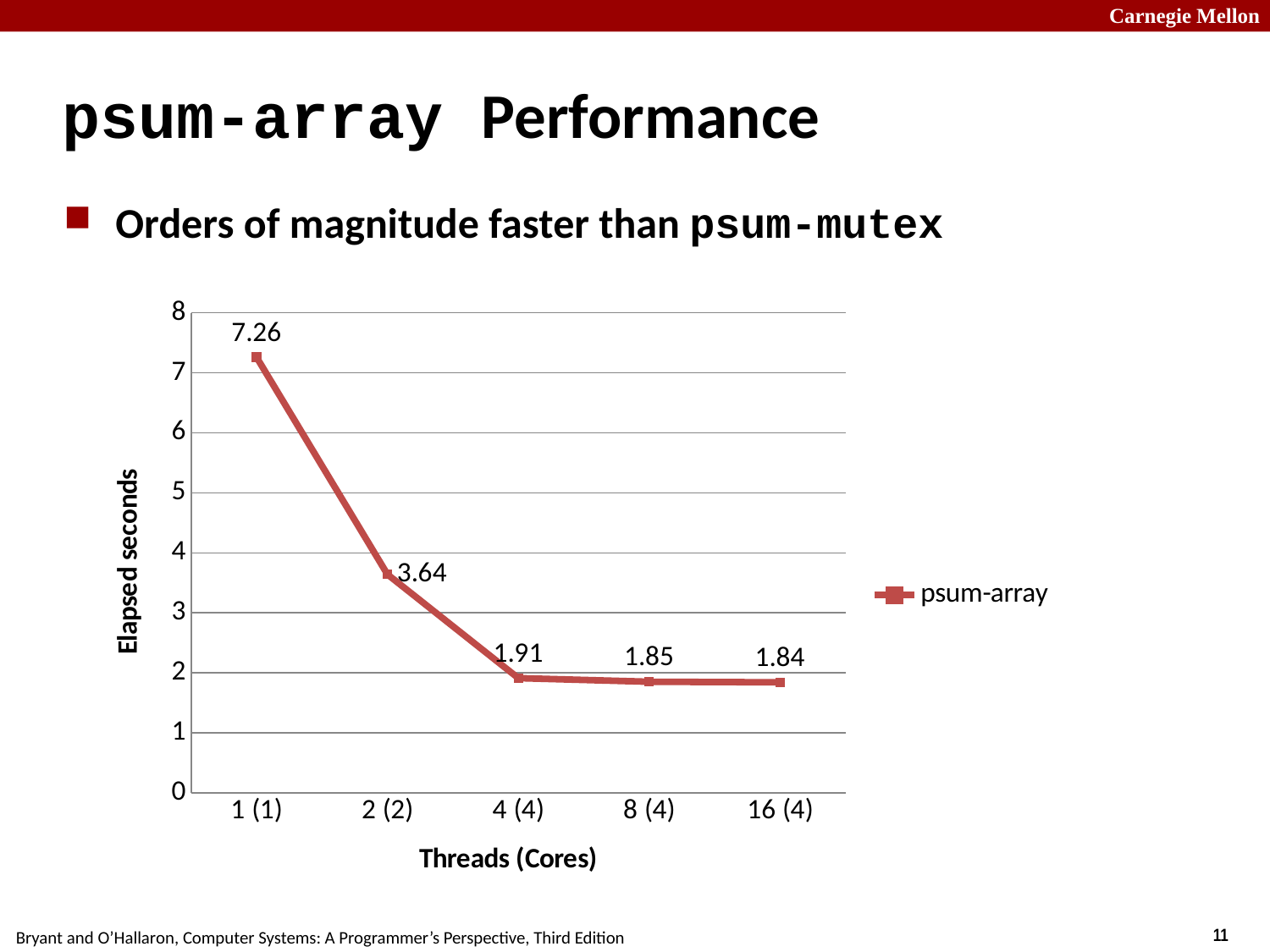
Which has a larger elapsed seconds value, 2 (2) threads or 8 (4) threads? 2 (2) What is the difference in elapsed seconds between 1 (1) and 2 (2) threads? 3.62 Which threads (cores) setting has the highest elapsed seconds? 1 (1) How many series does the legend list? 1 How many threads (cores) categories are plotted on the x axis? 5 What is the elapsed seconds value for 2 (2) threads (cores)? 3.64 Is the elapsed seconds value for 1 (1) threads greater or less than 7? greater What kind of chart is shown on the slide? line chart What is the elapsed seconds value for 16 (4) threads (cores)? 1.84 What is the elapsed seconds value for 1 (1) threads (cores)? 7.26 What is the difference in elapsed seconds between 2 (2) and 4 (4) threads? 1.73 What is the elapsed seconds value for 4 (4) threads (cores)? 1.91